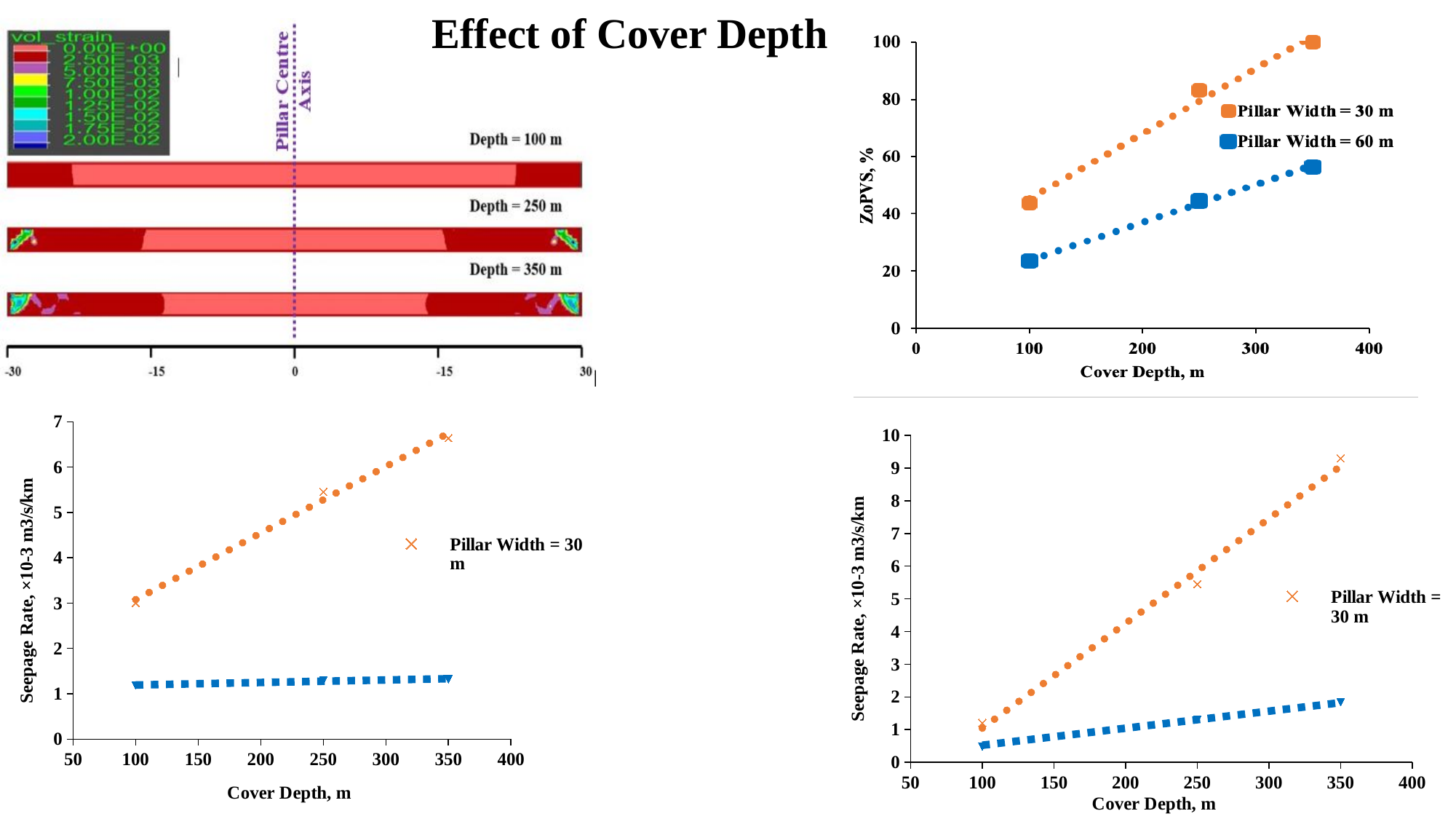
In the top-right chart (ZoPVS vs Cover Depth), does ZoPVS rise or fall as cover depth increases? rise What is the label of the y axis of the top-right chart? ZoPVS, % In the bottom-left chart (Seepage Rate vs Cover Depth), is the seepage rate for Pillar Width = 30 m at a cover depth of 350 m greater or less than 6? greater In the top-right chart (ZoPVS vs Cover Depth), how many series does the legend list? 2 In the top-right chart (ZoPVS vs Cover Depth), how many data points are plotted for the Pillar Width = 30 m series? 3 In the top-right chart (ZoPVS vs Cover Depth), is the ZoPVS value for Pillar Width = 30 m at a cover depth of 250 m greater or less than 60? greater In the bottom-left chart (Seepage Rate vs Cover Depth), is the seepage rate for Pillar Width = 30 m at a cover depth of 250 m greater or less than 5? greater In the top-right chart (ZoPVS vs Cover Depth), at a cover depth of 250 m, which series has the higher ZoPVS: Pillar Width = 30 m or Pillar Width = 60 m? Pillar Width = 30 m In the bottom-left chart (Seepage Rate vs Cover Depth), does the seepage rate for Pillar Width = 30 m rise or fall as cover depth increases? rise